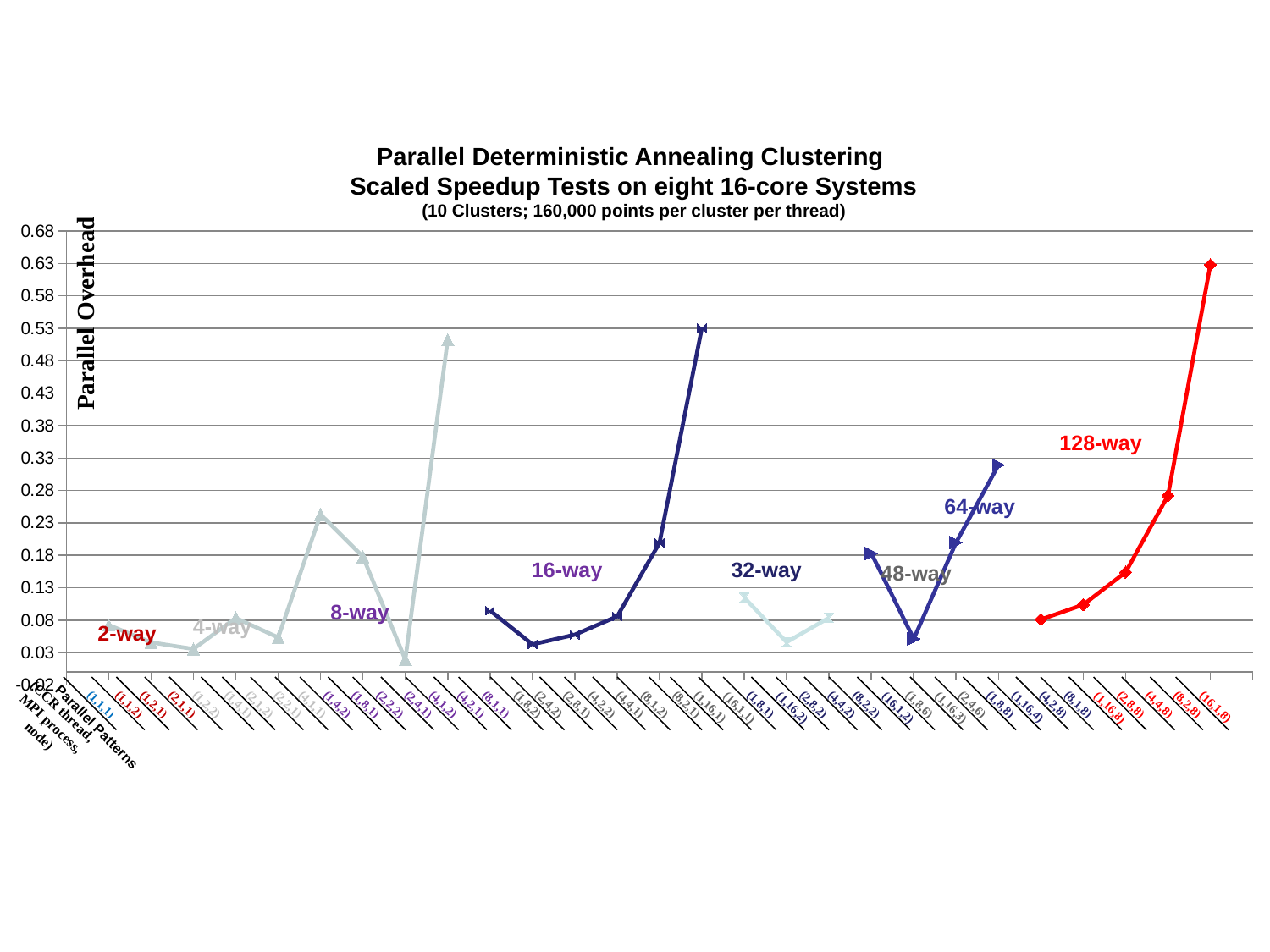
What is the label of the vertical axis? Parallel Overhead Does the parallel overhead for the 128-way series rise or fall from left to right along the x axis? rise Is the parallel overhead for the 2-way pattern (1,1,1) greater or less than 0.13? less What is the main title of the chart? Parallel Deterministic Annealing Clustering Scaled Speedup Tests on eight 16-core Systems Is the parallel overhead for the 8-way pattern (4,1,2) greater or less than 0.43? greater Which series reaches the highest parallel overhead on the chart? 128-way Is the parallel overhead for the 16-way pattern (1,16,1) greater or less than 0.48? greater What kind of chart is shown on the slide? line chart Which has the larger parallel overhead: the 128-way pattern (16,1,8) or the 16-way pattern (1,16,1)? 128-way (16,1,8)